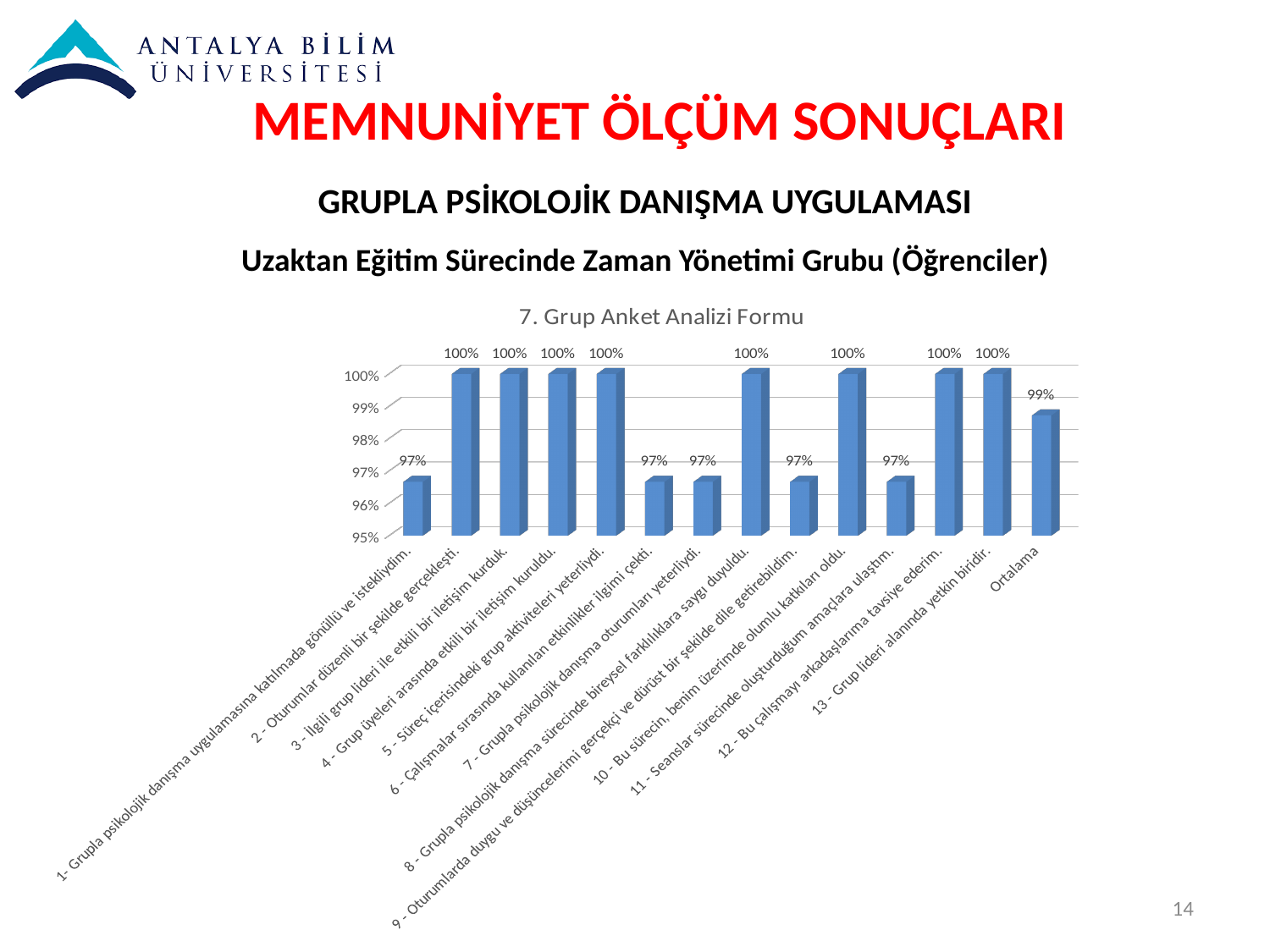
What is the title of the chart? 7. Grup Anket Analizi Formu What is the value for "Ortalama"? 99% What is the difference between the value for item 2 and the value for item 1? 3% What is the value for item 2, "Oturumlar düzenli bir şekilde gerçekleşti."? 100% How many bars are plotted in the chart? 14 What is the value for item 1, "Grupla psikolojik danışma uygulamasına katılmada gönüllü ve istekliydim."? 97% What is the value for item 6, "Çalışmalar sırasında kullanılan etkinlikler ilgimi çekti."? 97% What is the lowest value shown in the chart? 97% What kind of chart is shown on the slide? bar chart Is the value for "Ortalama" greater or less than 98%? greater Which is larger, the value for item 7 or the value for item 8? item 8 What is the value for item 13, "Grup lideri alanında yetkin biridir."? 100%